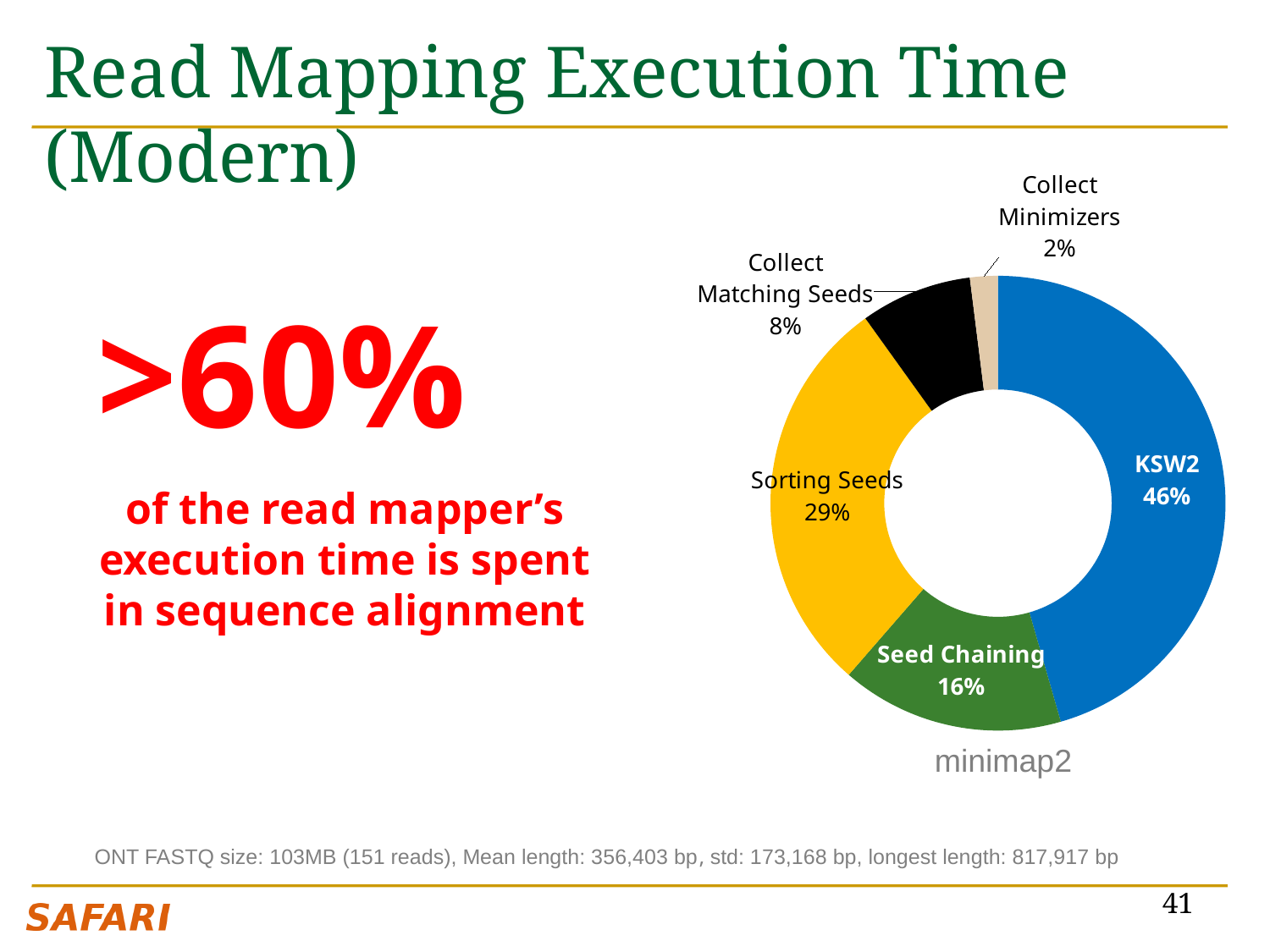
What kind of chart is shown on the slide? Pie chart (doughnut) How many stages are shown in the chart? 5 How many percentage points larger is KSW2's share than Sorting Seeds' share? 17 Which takes a larger share, Seed Chaining or Collect Matching Seeds? Seed Chaining Which stage takes the smallest share of execution time? Collect Minimizers Which stage takes the largest share of execution time? KSW2 What percentage is shown for Collect Minimizers? 2% What percentage is shown for Seed Chaining? 16% What percentage is shown for Collect Matching Seeds? 8% What is the combined share of KSW2 and Seed Chaining? 62% What percentage is shown for Sorting Seeds? 29% What share of execution time does KSW2 take in the minimap2 chart? 46%